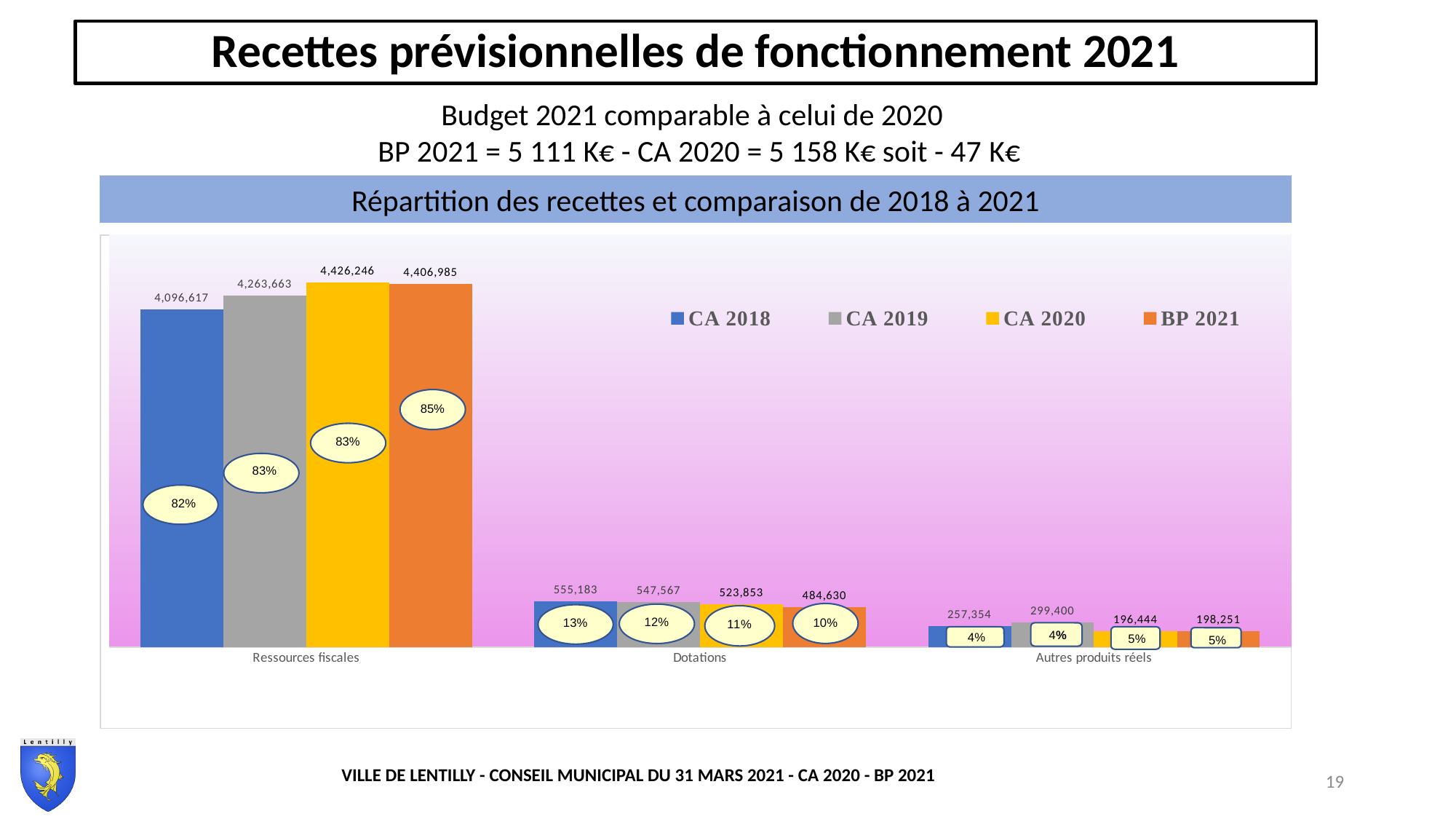
What kind of chart is shown? Bar chart Which series has the lowest value for Autres produits réels? CA 2020 What is the value of BP 2021 for Dotations? 484,630 What is the value of CA 2019 for Autres produits réels? 299,400 How many categories are shown on the x axis? 3 How many series does the legend list? 4 Which series has the highest value for Ressources fiscales? CA 2020 Which is larger for Autres produits réels: CA 2018 or BP 2021? CA 2018 What percentage share is shown for BP 2021 in Ressources fiscales? 85% Do the Dotations values rise or fall from CA 2018 to BP 2021? Fall What is the value of CA 2020 for Ressources fiscales? 4,426,246 What is the difference between CA 2018 and BP 2021 for Dotations? 70,553